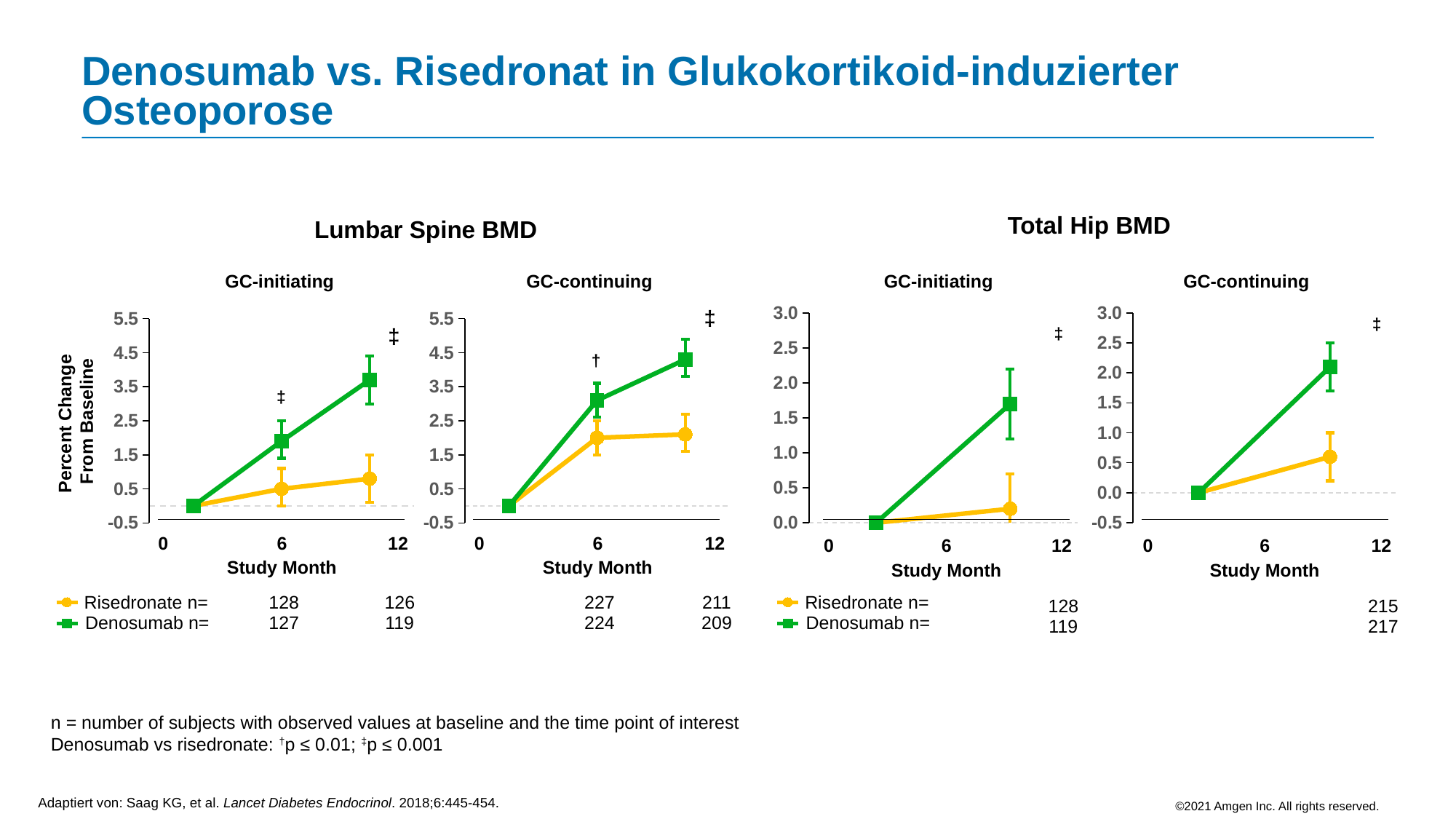
In the Lumbar Spine BMD GC-continuing chart, which series has the higher value at month 12, Denosumab or Risedronate? Denosumab What type of chart is used for the Lumbar Spine BMD GC-initiating panel? line chart In the Lumbar Spine BMD GC-initiating chart, is the Risedronate value at month 12 greater or less than 1.5? less In the Total Hip BMD GC-initiating chart, is the Risedronate value at month 12 greater or less than 0.5? less In the Lumbar Spine BMD GC-initiating chart, is the Denosumab value at month 12 greater or less than 2.5? greater In the Total Hip BMD GC-continuing chart, which series has the higher value at month 12, Denosumab or Risedronate? Denosumab What is the y-axis label of the Lumbar Spine BMD GC-initiating chart? Percent Change From Baseline How many series does the legend list for the Lumbar Spine BMD charts? 2 How many time points are plotted for each series in the Lumbar Spine BMD GC-continuing chart? 3 In the Lumbar Spine BMD GC-initiating chart, does the Denosumab series rise or fall from month 0 to month 12? rise